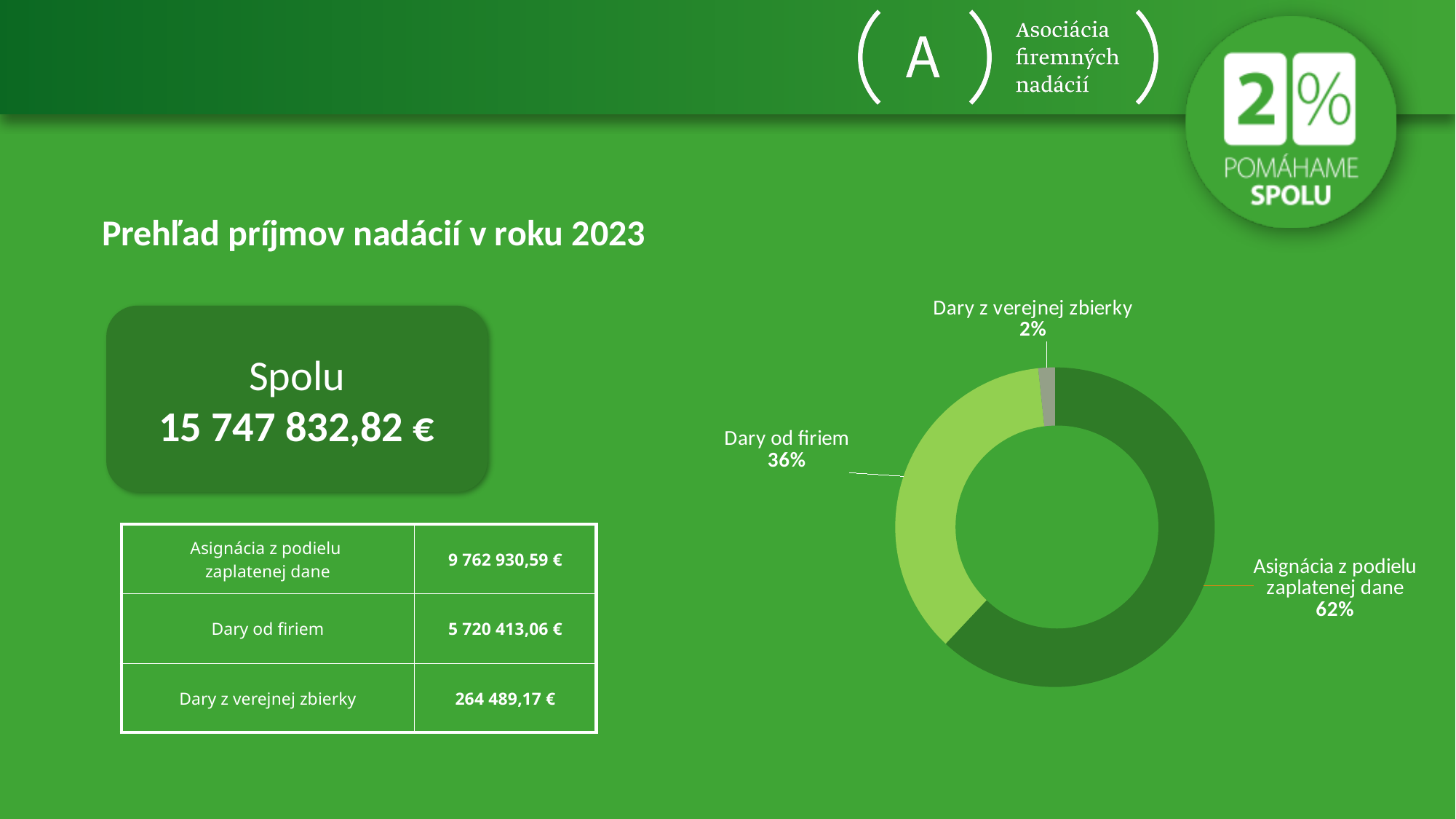
How many categories are shown in the doughnut chart? 3 Which slice is larger in the doughnut chart: "Dary od firiem" or "Dary z verejnej zbierky"? Dary od firiem What kind of chart is shown on the slide? Doughnut chart What share of the doughnut chart does "Asignácia z podielu zaplatenej dane" represent? 62% Which category has the largest slice in the doughnut chart? Asignácia z podielu zaplatenej dane Which category has the smallest slice in the doughnut chart? Dary z verejnej zbierky What is the difference in percentage points between the "Dary od firiem" slice and the "Dary z verejnej zbierky" slice? 34 percentage points What share of the doughnut chart does "Dary od firiem" represent? 36% What is the title of the slide containing the doughnut chart? Prehľad príjmov nadácií v roku 2023 What share of the doughnut chart does "Dary z verejnej zbierky" represent? 2% What is the difference in percentage points between the "Asignácia z podielu zaplatenej dane" slice and the "Dary od firiem" slice? 26 percentage points What colour is the "Dary z verejnej zbierky" slice in the doughnut chart? Grey